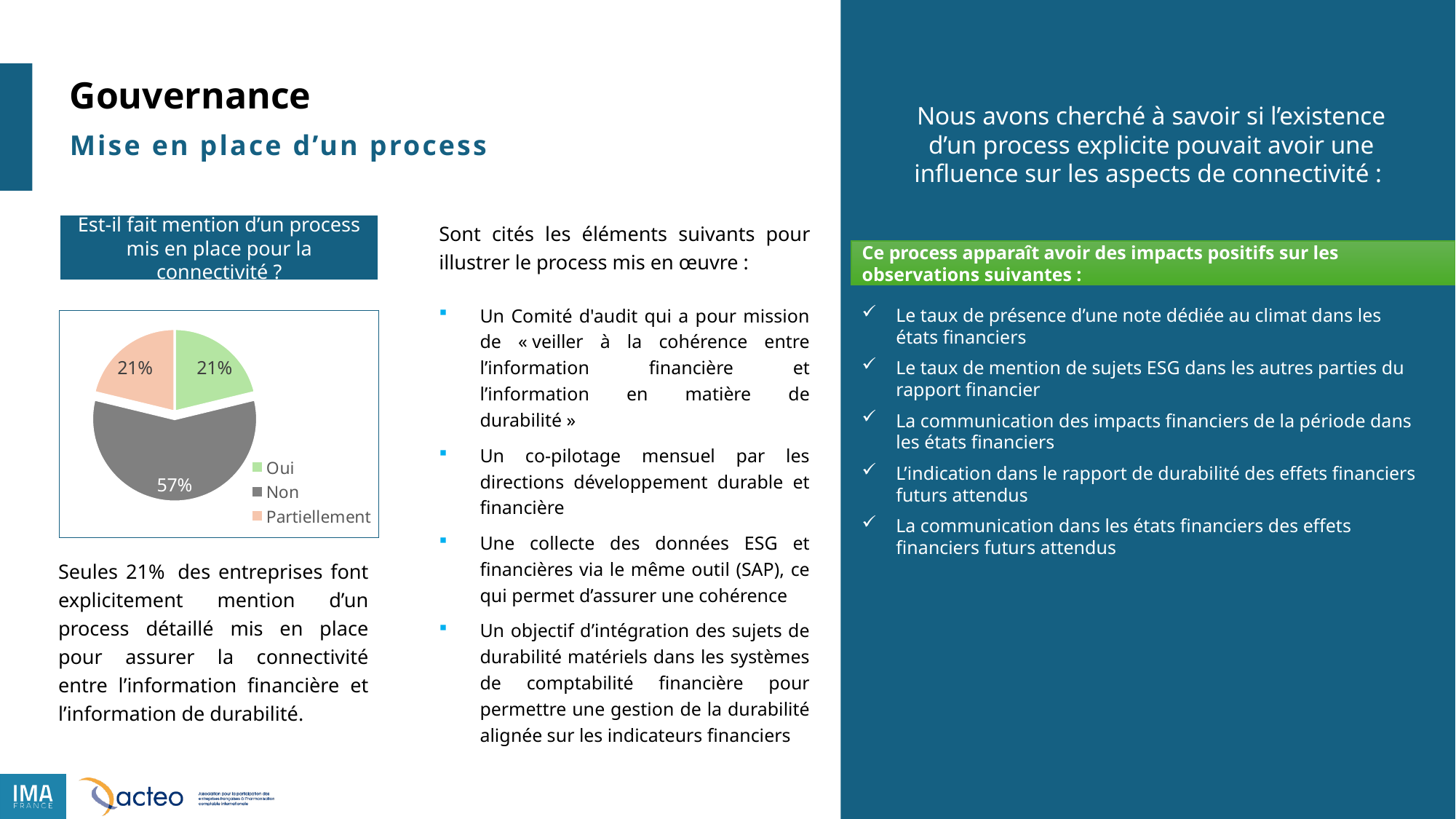
What share of the pie is labelled "Oui"? 21% What is the difference between the "Non" share and the "Oui" share? 36% Is the value for "Non" greater or less than 50%? greater What is the combined share of "Oui" and "Partiellement"? 42% What share of the pie is labelled "Partiellement"? 21% What colour is the "Non" slice in the pie chart? grey How many slices does the pie chart have? 3 How many entries does the legend of the pie chart list? 3 What share of the pie is labelled "Non"? 57% Which is larger, the "Non" slice or the "Partiellement" slice? Non What kind of chart is shown on the slide? pie chart Which category has the largest slice of the pie? Non